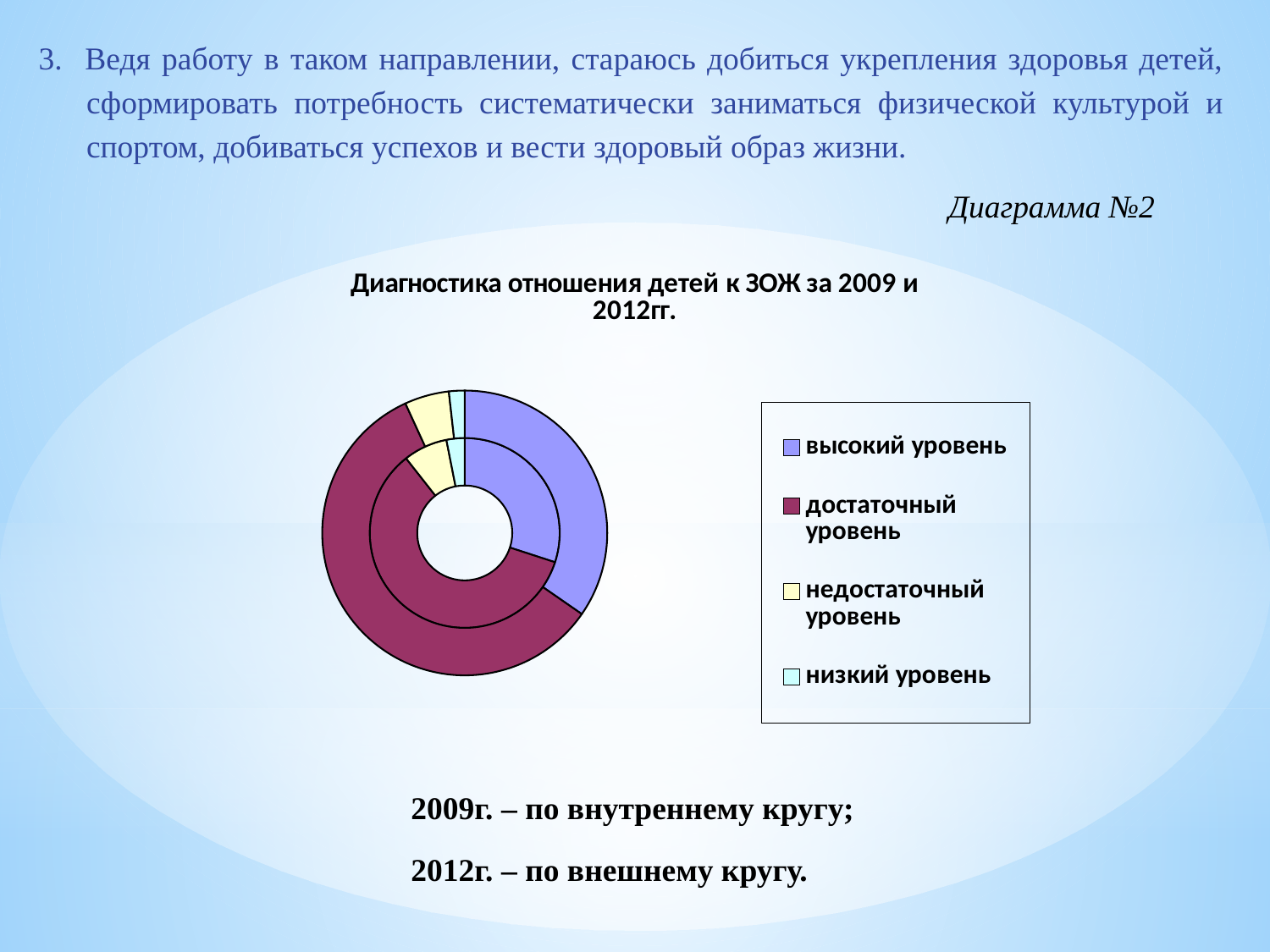
How many rings (years) does the doughnut chart show? 2 Which category has the smallest share in the inner ring (2009г.)? низкий уровень Which category has the smallest share in the outer ring (2012г.)? низкий уровень Which category has the largest share in the inner ring (2009г.)? достаточный уровень In the inner ring (2009г.), which is larger: достаточный уровень or высокий уровень? достаточный уровень What is the title of the chart? Диагностика отношения детей к ЗОЖ за 2009 и 2012гг. Which year's data is shown on the inner ring of the chart? 2009г. What kind of chart is shown on the slide? Doughnut chart How many categories does the legend of the chart list? 4 In the outer ring (2012г.), which is larger: высокий уровень or недостаточный уровень? высокий уровень Which category has the largest share in the outer ring (2012г.)? достаточный уровень